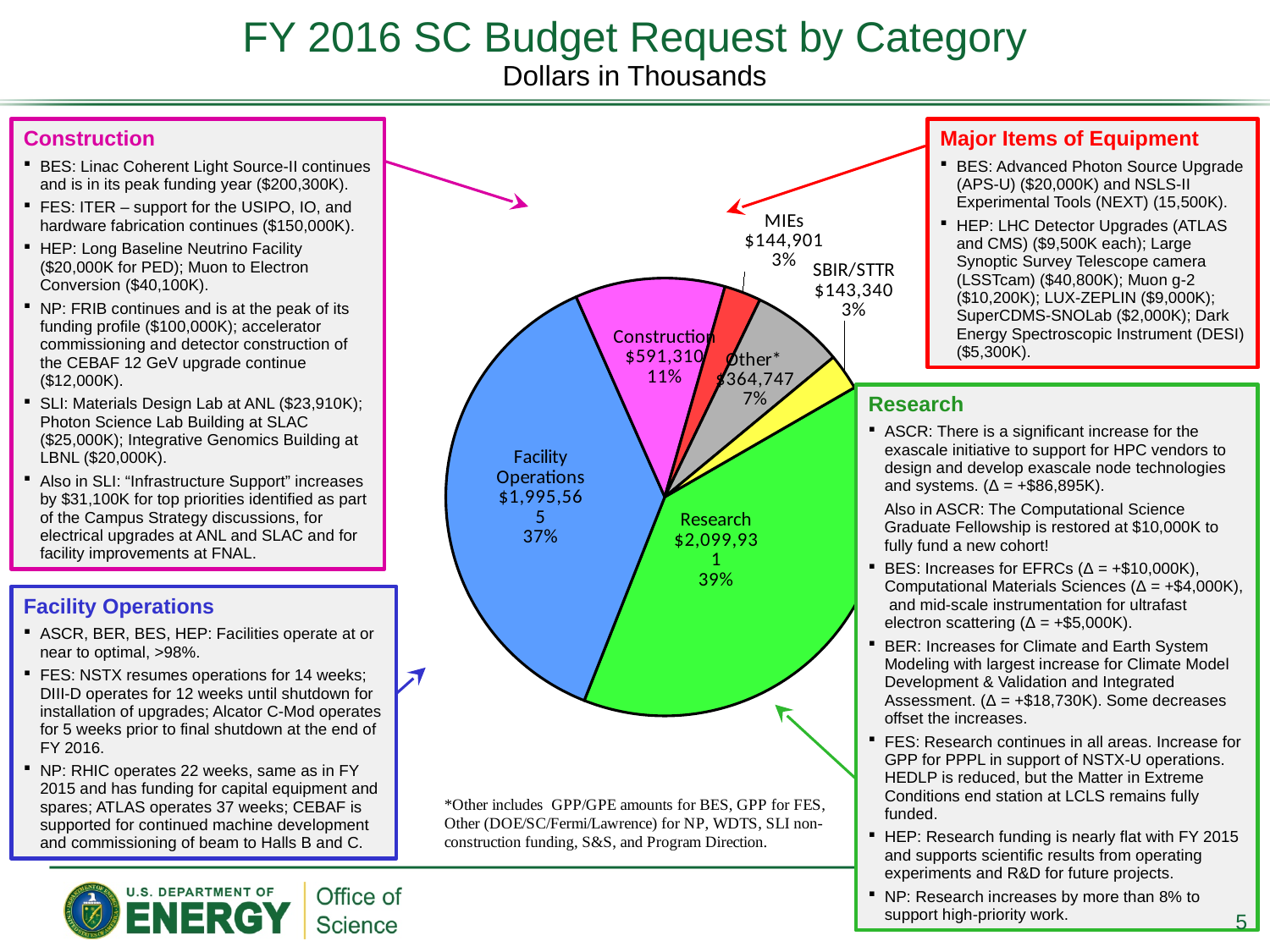
Which is larger, the value for Construction or the value for Other*? Construction What is the value shown for Facility Operations in the pie chart? $1,995,565 What kind of chart is shown on the slide? pie chart What is the value shown for Research in the pie chart? $2,099,931 How many categories (slices) does the pie chart show? 6 What is the value shown for Construction in the pie chart? $591,310 What is the difference between the Research value and the Facility Operations value? $104,366 Which category has the largest share of the pie chart? Research What unit are the dollar values in the chart expressed in, according to the subtitle? Dollars in Thousands What percentage share of the pie does Construction represent? 11% What is the value shown for MIEs in the pie chart? $144,901 What percentage share of the pie does Other* represent? 7%